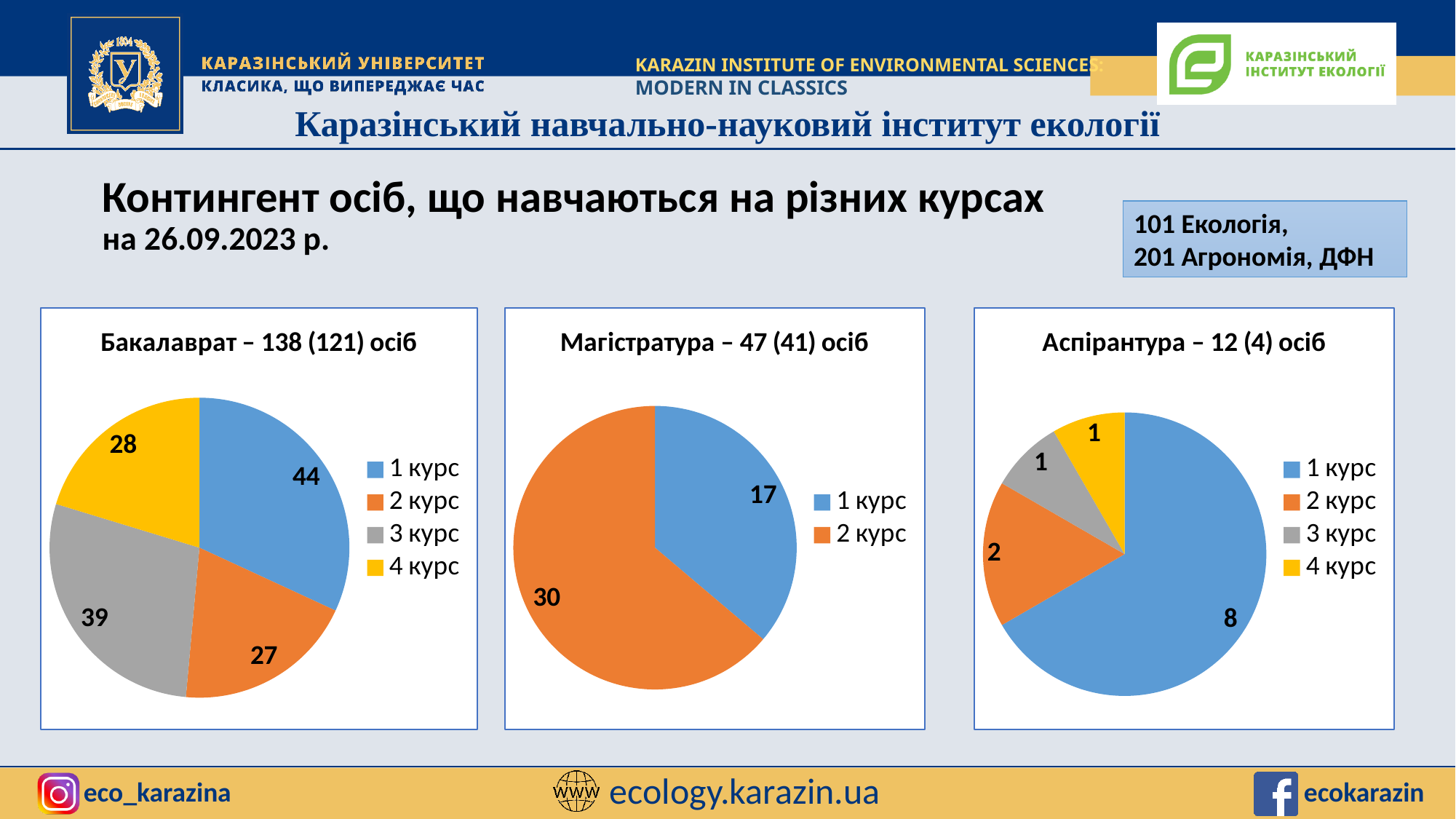
In the 'Магістратура – 47 (41) осіб' chart, what is the difference between 2 курс and 1 курс? 13 In the 'Магістратура – 47 (41) осіб' chart, how many entries does the legend list? 2 In the 'Бакалаврат – 138 (121) осіб' chart, what is the difference between the values for 1 курс and 3 курс? 5 What type of chart is the 'Аспірантура – 12 (4) осіб' chart? pie chart In the 'Аспірантура – 12 (4) осіб' chart, which course has the highest value? 1 курс In the 'Бакалаврат – 138 (121) осіб' chart, what is the value for 1 курс? 44 In the 'Бакалаврат – 138 (121) осіб' chart, which course has the lowest value? 2 курс In the 'Аспірантура – 12 (4) осіб' chart, what is the value for 1 курс? 8 In the 'Магістратура – 47 (41) осіб' chart, what is the value for 2 курс? 30 In the 'Магістратура – 47 (41) осіб' chart, which is larger, 1 курс or 2 курс? 2 курс In the 'Аспірантура – 12 (4) осіб' chart, what colour is the slice for 3 курс? grey In the 'Бакалаврат – 138 (121) осіб' chart, how many slices does the pie have? 4